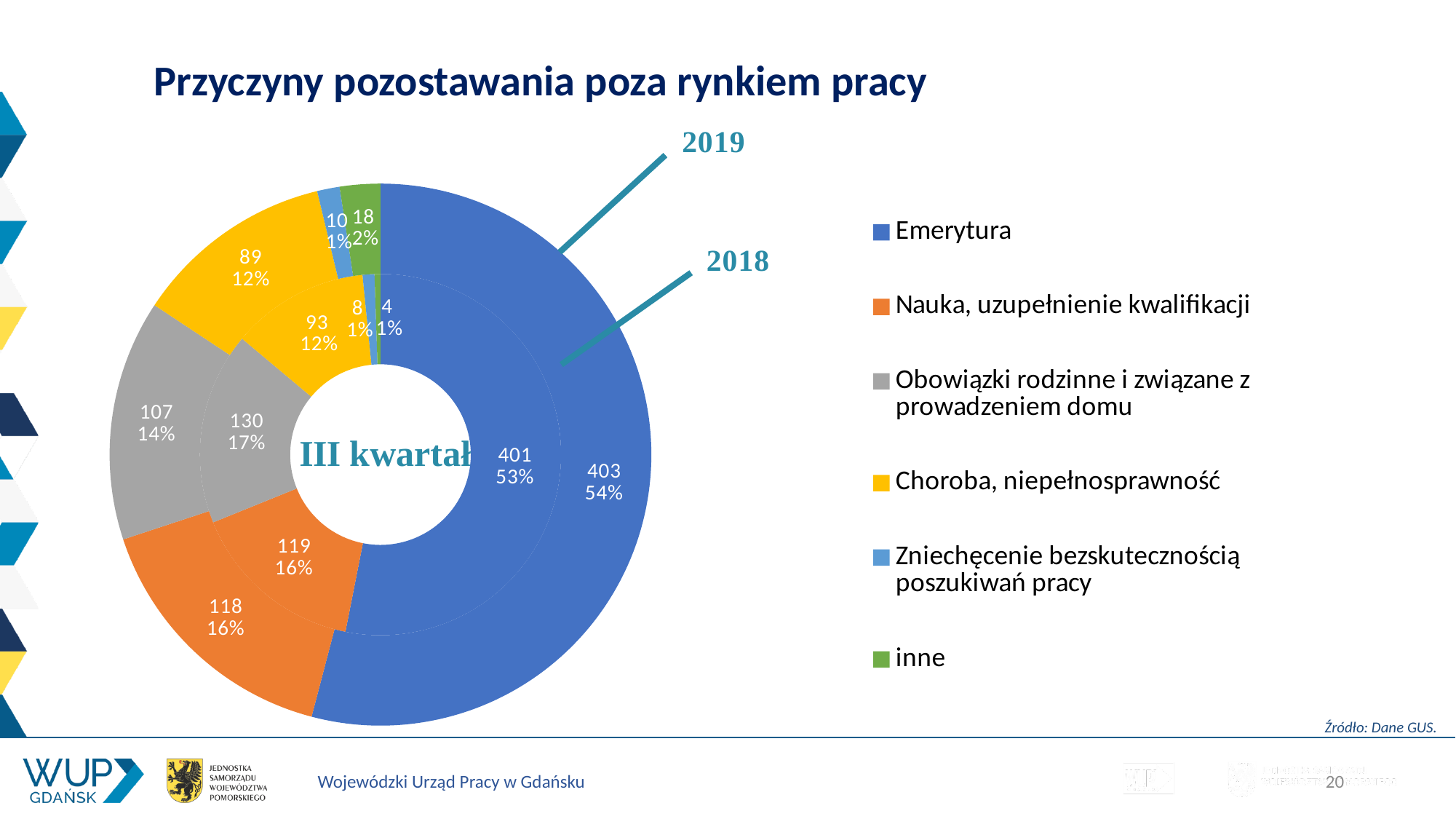
How many categories does the legend list? 6 What percentage share does Nauka, uzupełnienie kwalifikacji have in the 2019 ring? 16% Which category has the largest share in the 2019 ring? Emerytura What percentage share does Emerytura have in the inner ring (2018)? 53% Which is larger: the value for inne in 2019 or the value for inne in 2018? 2019 Which quarter does the chart refer to, according to the text in the centre of the doughnut? III kwartał What is the difference between the Obowiązki rodzinne values for 2018 (130) and 2019 (107)? 23 Which category has the smallest value in the 2018 ring? inne What is the value for Choroba, niepełnosprawność in the 2019 ring? 89 What kind of chart is shown on the slide? Doughnut chart What is the value for Emerytura in the outer ring (2019)? 403 What is the value for Obowiązki rodzinne i związane z prowadzeniem domu in the 2018 ring? 130